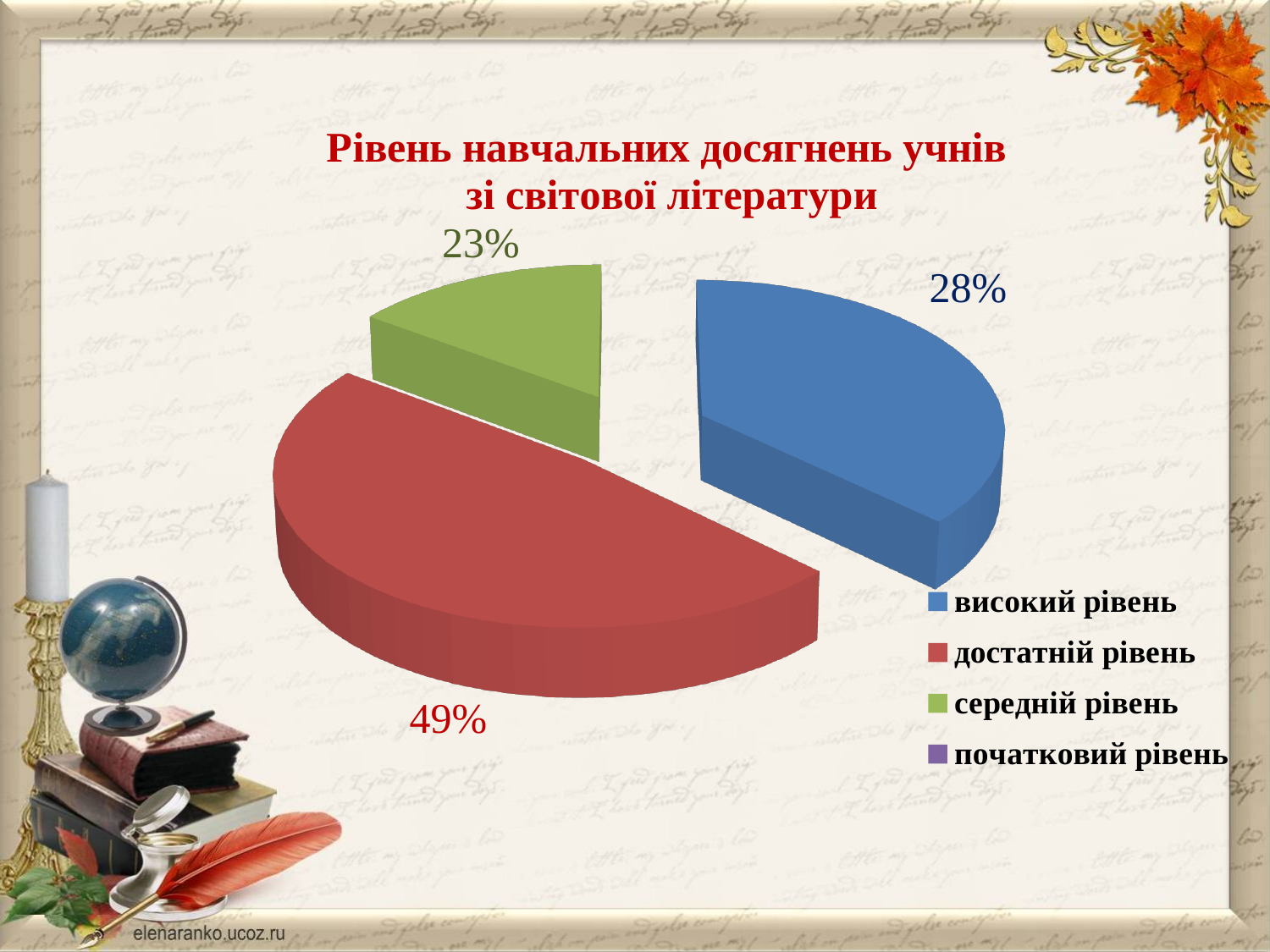
What is the title of the chart? Рівень навчальних досягнень учнів зі світової літератури What colour represents достатній рівень in the chart? red What percentage of students are at the середній рівень? 23% How many slices with printed percentage labels are visible in the pie? 3 What percentage of students are at the достатній рівень? 49% What is the difference in percentage points between достатній рівень and високий рівень? 21 How many entries does the legend list? 4 What percentage of students are at the високий рівень? 28% Which level has the largest share of the pie? достатній рівень Among the slices with printed values, which level has the smallest share? середній рівень Which is larger, the share for високий рівень or the share for середній рівень? високий рівень What type of chart is shown on the slide? pie chart